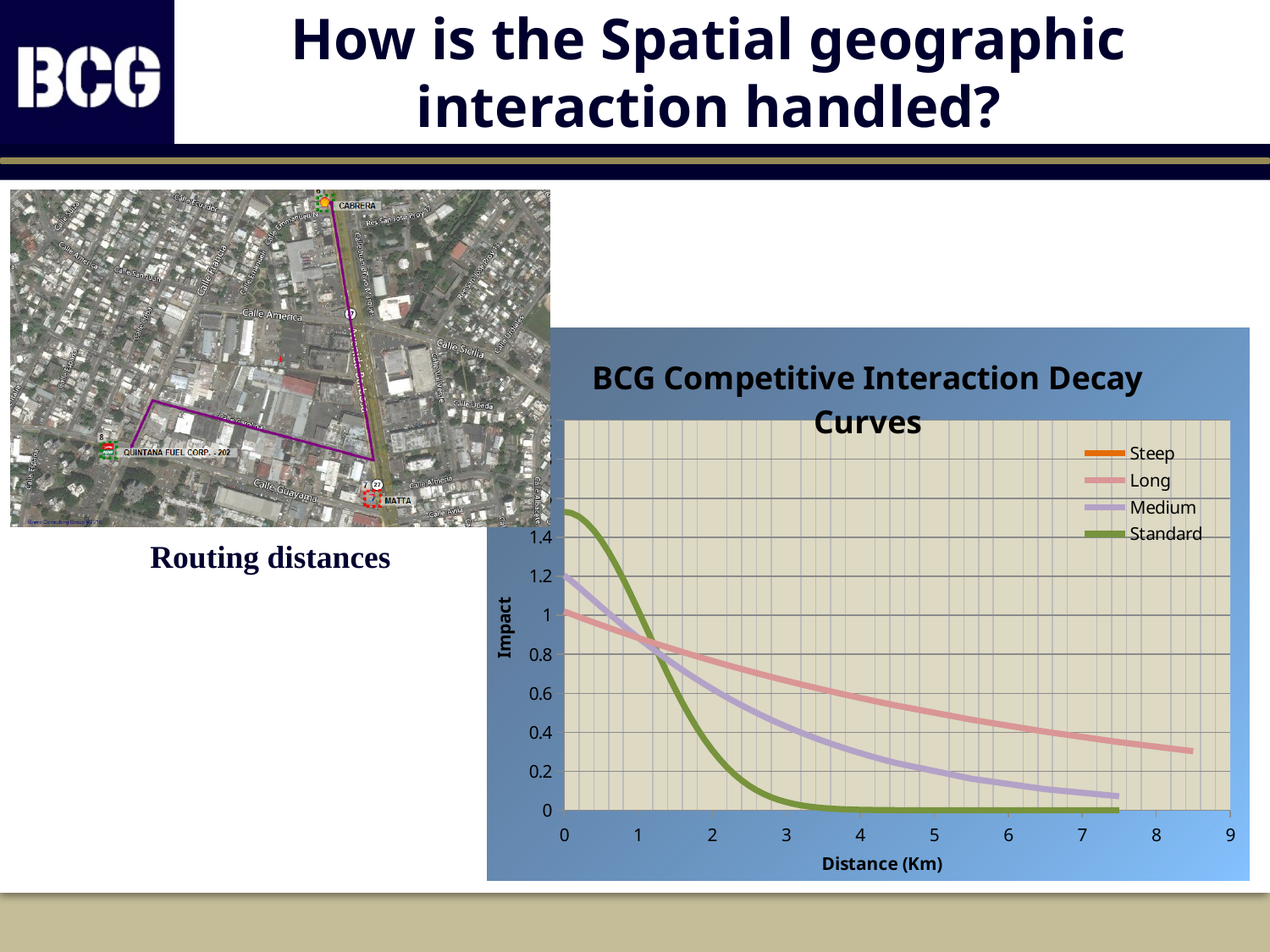
How many series does the legend of the 'BCG Competitive Interaction Decay Curves' chart list? 4 In the 'BCG Competitive Interaction Decay Curves' chart, is the Impact of the Standard curve at a distance of 3 km greater or less than 0.2? less What is the label of the x axis of the 'BCG Competitive Interaction Decay Curves' chart? Distance (Km) In the 'BCG Competitive Interaction Decay Curves' chart, is the Impact of the Medium curve at a distance of 6 km greater or less than 0.4? less In the 'BCG Competitive Interaction Decay Curves' chart, is the Impact of the Standard curve at a distance of 0 km greater or less than 1.4? greater In the 'BCG Competitive Interaction Decay Curves' chart, which curve has the highest Impact at a distance of 6 km? Long In the 'BCG Competitive Interaction Decay Curves' chart, which curve has the higher Impact at a distance of 2 km, Standard or Medium? Medium What kind of chart is the 'BCG Competitive Interaction Decay Curves' chart? line chart What is the title of the chart on the slide? BCG Competitive Interaction Decay Curves In the 'BCG Competitive Interaction Decay Curves' chart, does the Impact of the Long curve rise or fall as Distance increases? fall In the 'BCG Competitive Interaction Decay Curves' chart, which curve has the higher Impact at a distance of 4 km, Long or Medium? Long